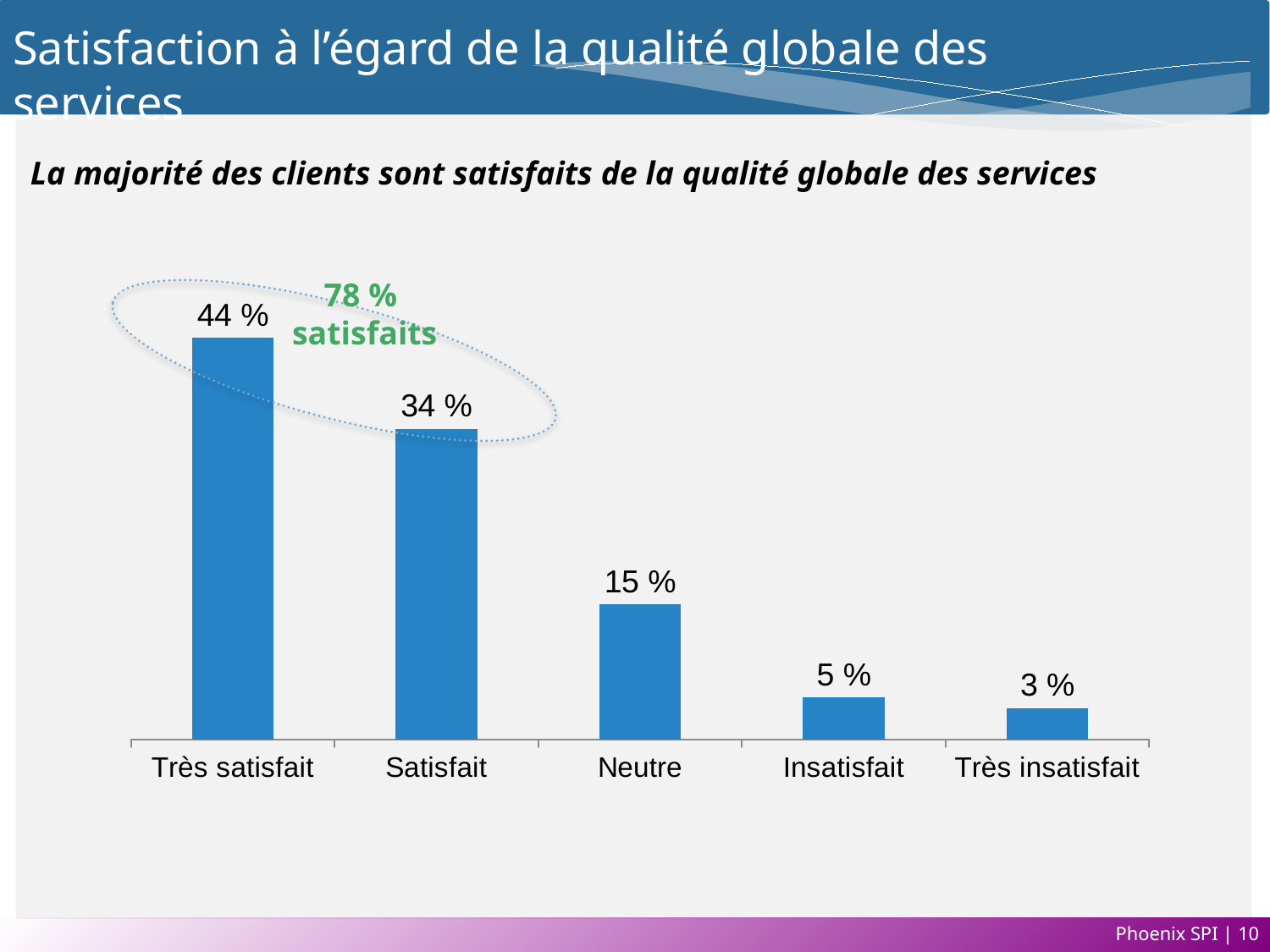
What is the value for Très satisfait? 44 % What is the value for Neutre? 15 % What kind of chart is shown on the slide? Bar chart What percentage is shown in the green annotation as satisfied (satisfaits)? 78 % What is the value for Satisfait? 34 % What is the difference between the values for Très satisfait and Satisfait? 10 % Which category has the lowest value? Très insatisfait What is the value for Très insatisfait? 3 % How many categories are shown on the x axis? 5 Which category has the highest value? Très satisfait What is the value for Insatisfait? 5 % Which is larger, the value for Neutre or the value for Insatisfait? Neutre